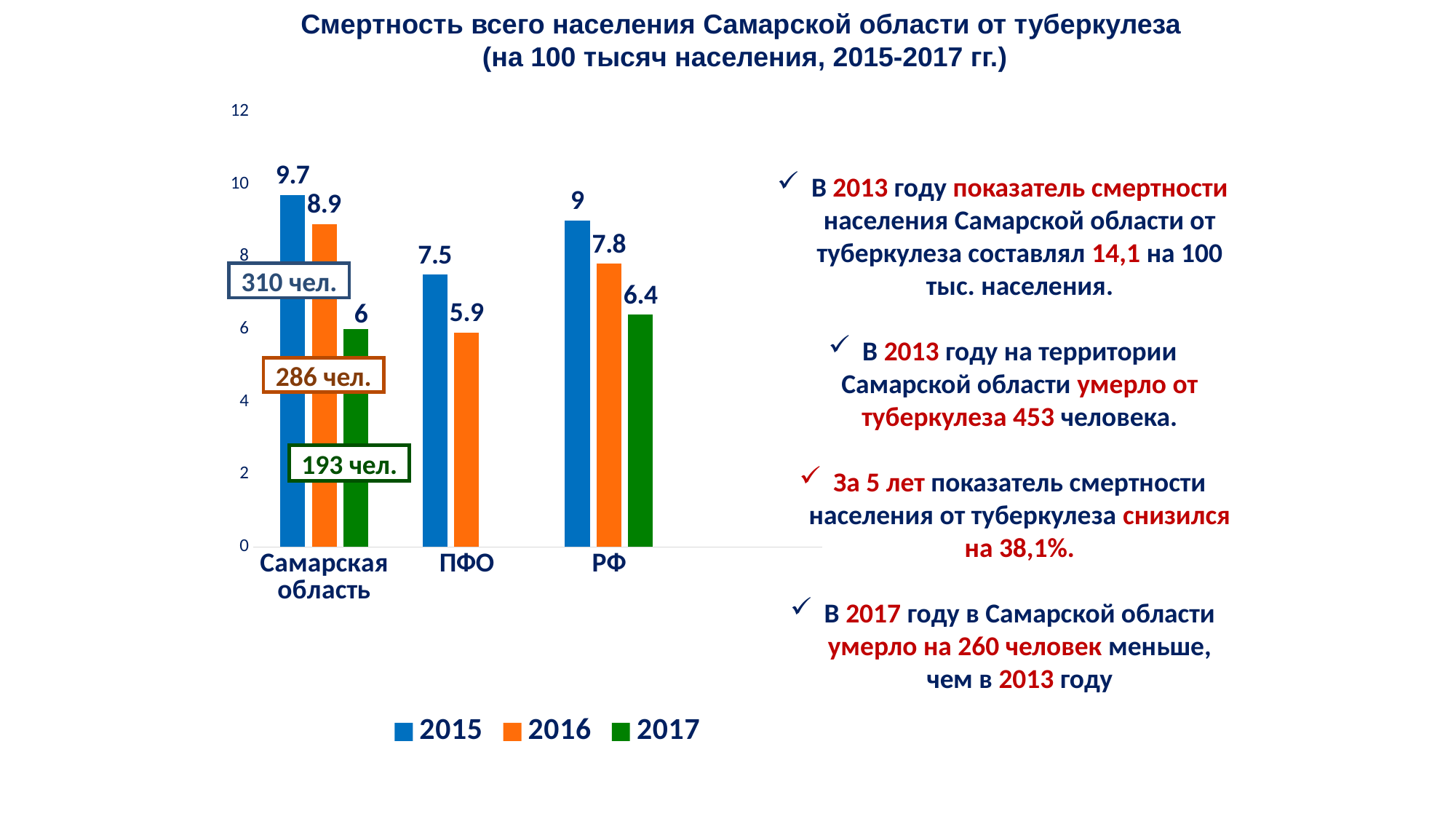
What kind of chart is shown on the slide? bar chart How many categories are shown on the x axis? 3 What is the value for ПФО in 2016? 5.9 Which category has the highest value in 2015? Самарская область How many series does the legend list? 3 Do the values for РФ rise or fall from 2015 to 2017? fall What is the value for РФ in 2017? 6.4 What is the difference between the 2015 and 2017 values for Самарская область? 3.7 What is the value for Самарская область in 2015? 9.7 Which colour represents the 2017 series in the legend? green Which is larger: the 2016 value for Самарская область or the 2016 value for РФ? Самарская область Which category has the lowest value in 2016? ПФО